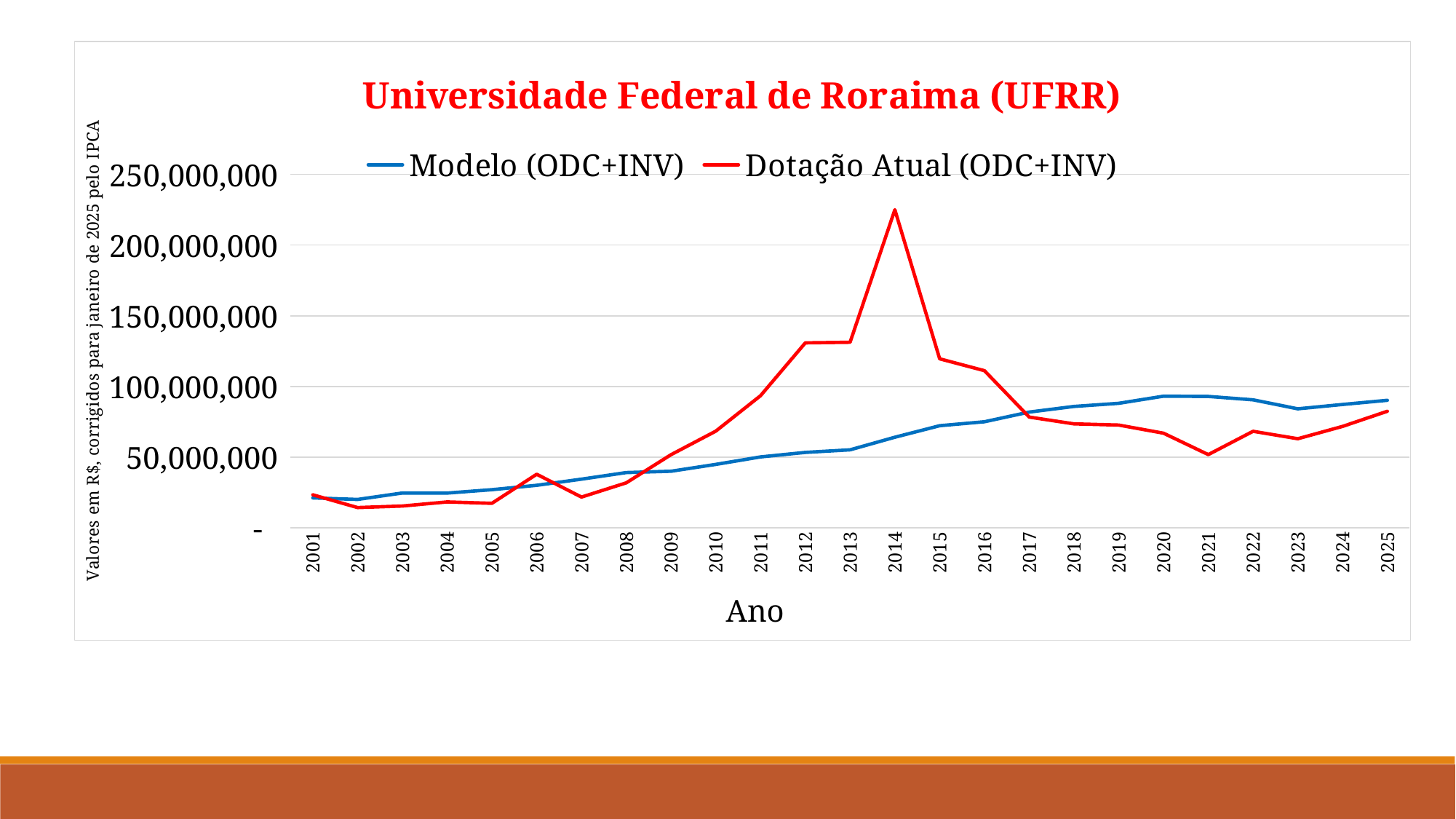
How many years are plotted along the x axis? 25 Is the value of Dotação Atual (ODC+INV) in 2021 greater or less than 100,000,000? less What is the title of the chart? Universidade Federal de Roraima (UFRR) Is the value of Modelo (ODC+INV) in 2001 greater or less than 50,000,000? less What kind of chart is shown on the slide? line chart Is the value of Dotação Atual (ODC+INV) in 2014 greater or less than 200,000,000? greater Does the Modelo (ODC+INV) series generally rise or fall from 2001 to 2020? rise How many series does the legend list? 2 In which year does the Dotação Atual (ODC+INV) series reach its highest value? 2014 In 2021, which series has the larger value, Modelo (ODC+INV) or Dotação Atual (ODC+INV)? Modelo (ODC+INV) In 2014, which series has the larger value, Modelo (ODC+INV) or Dotação Atual (ODC+INV)? Dotação Atual (ODC+INV)